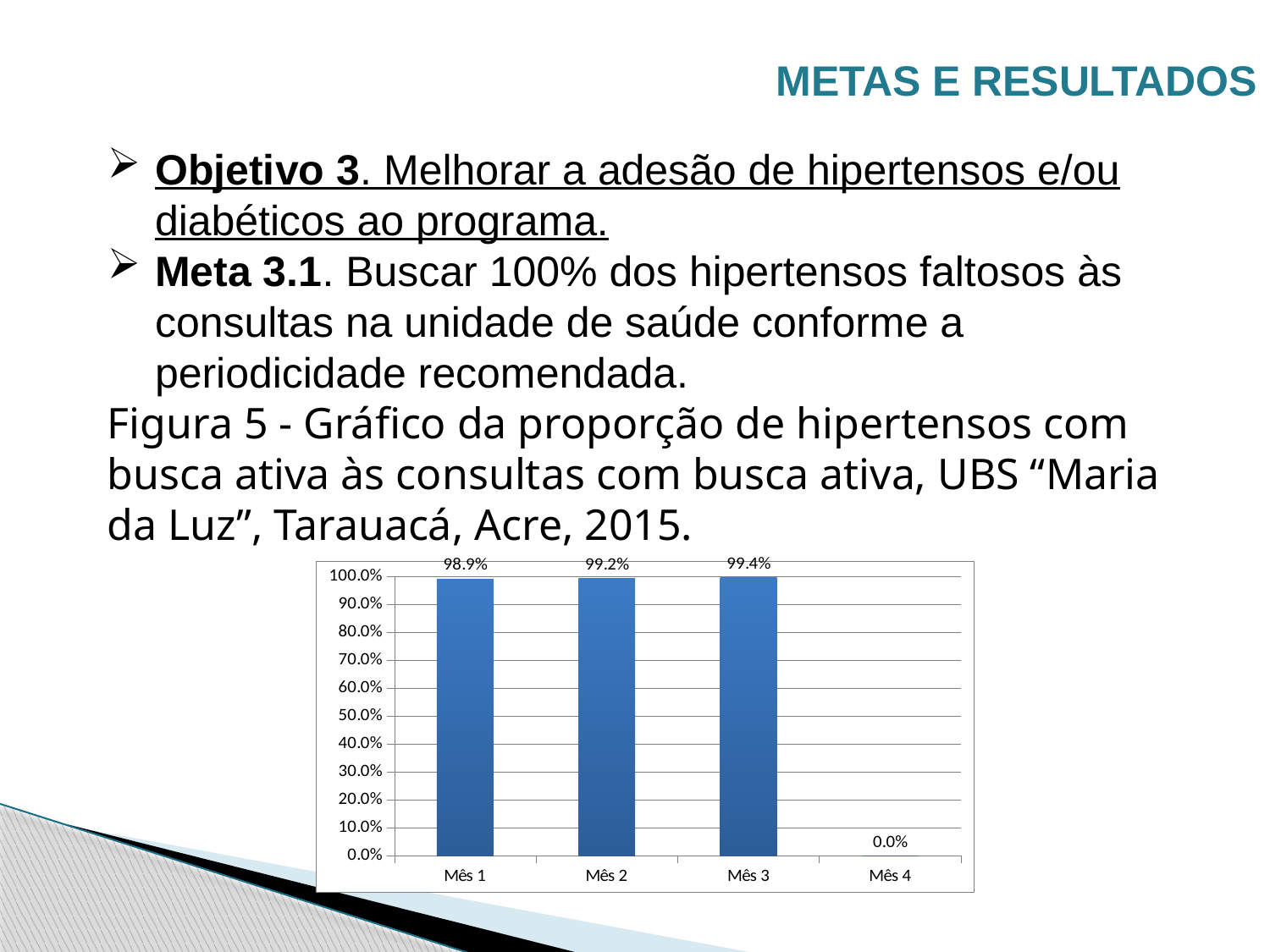
What is the value for Mês 2? 99.2% What is the value for Mês 3? 99.4% Which month has the lowest value? Mês 4 What is the value for Mês 4? 0.0% What kind of chart is shown on the slide? bar chart Which is larger, the value for Mês 2 or the value for Mês 1? Mês 2 How many months are shown on the x axis? 4 What is the value for Mês 1? 98.9% What is the highest tick value shown on the y axis? 100.0% Is the value for Mês 2 greater or less than 90.0%? greater Which month has the highest value? Mês 3 What is the difference between the values for Mês 3 and Mês 1? 0.5%